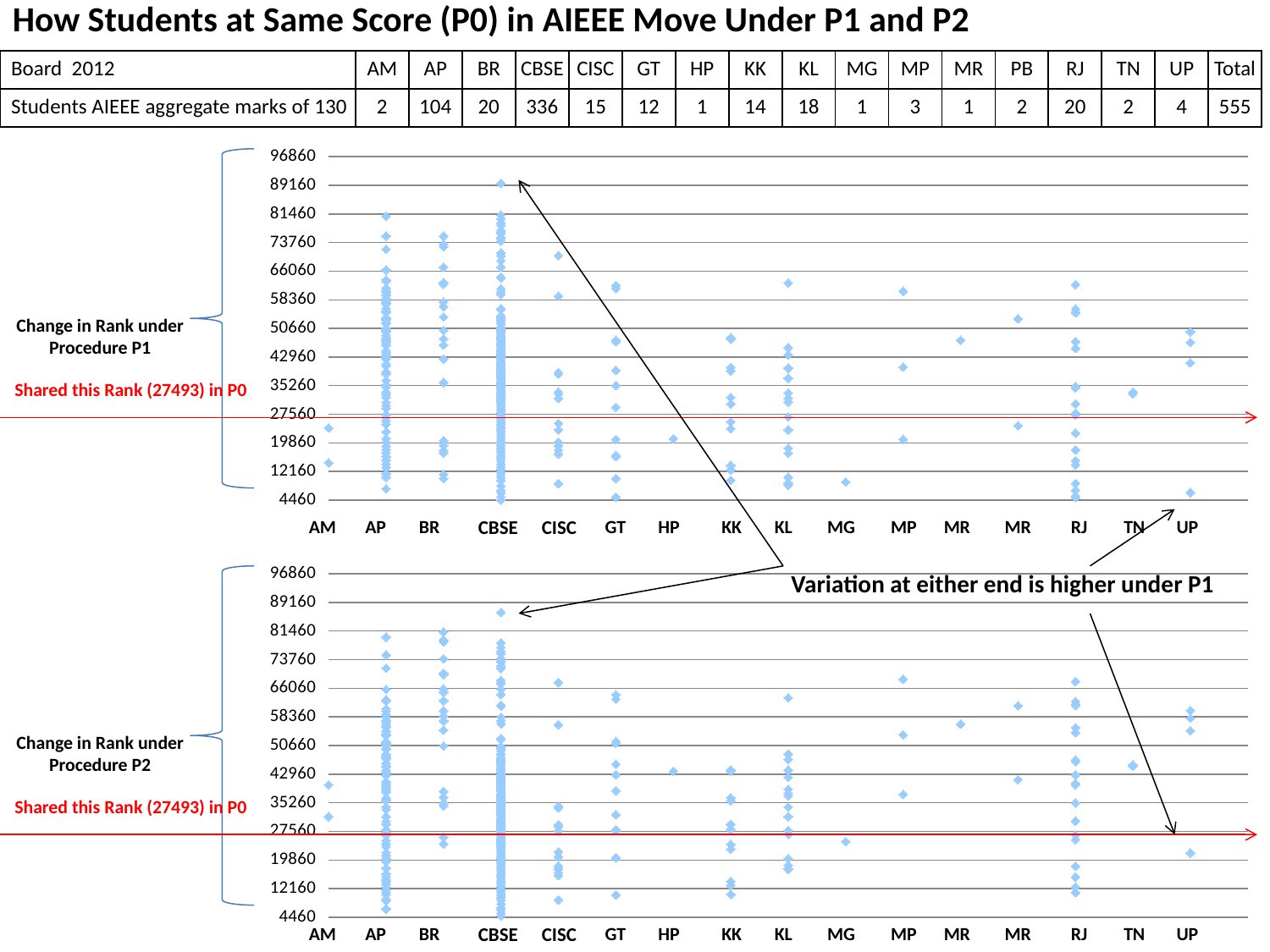
In the top chart (Procedure P1), is the value for MG greater or less than 12160? less How many board categories are labelled along the x axis of the top chart (Procedure P1)? 16 In the bottom chart (Procedure P2), is the value for MG greater or less than 27560? less In the top chart (Procedure P1), is the value for TN greater or less than 27560? greater What kind of chart is the top chart, 'Change in Rank under Procedure P1'? scatter chart In the bottom chart (Procedure P2), which is higher, the point for HP or the point for MG? HP What is the highest tick value shown on the y axis of the top chart (Procedure P1)? 96860 What rank value does the red horizontal line in the bottom chart represent as shared in P0? 27493 In the top chart (Procedure P1), which board has the single highest plotted point? CBSE In the bottom chart (Procedure P2), which board has the single highest plotted point? CBSE